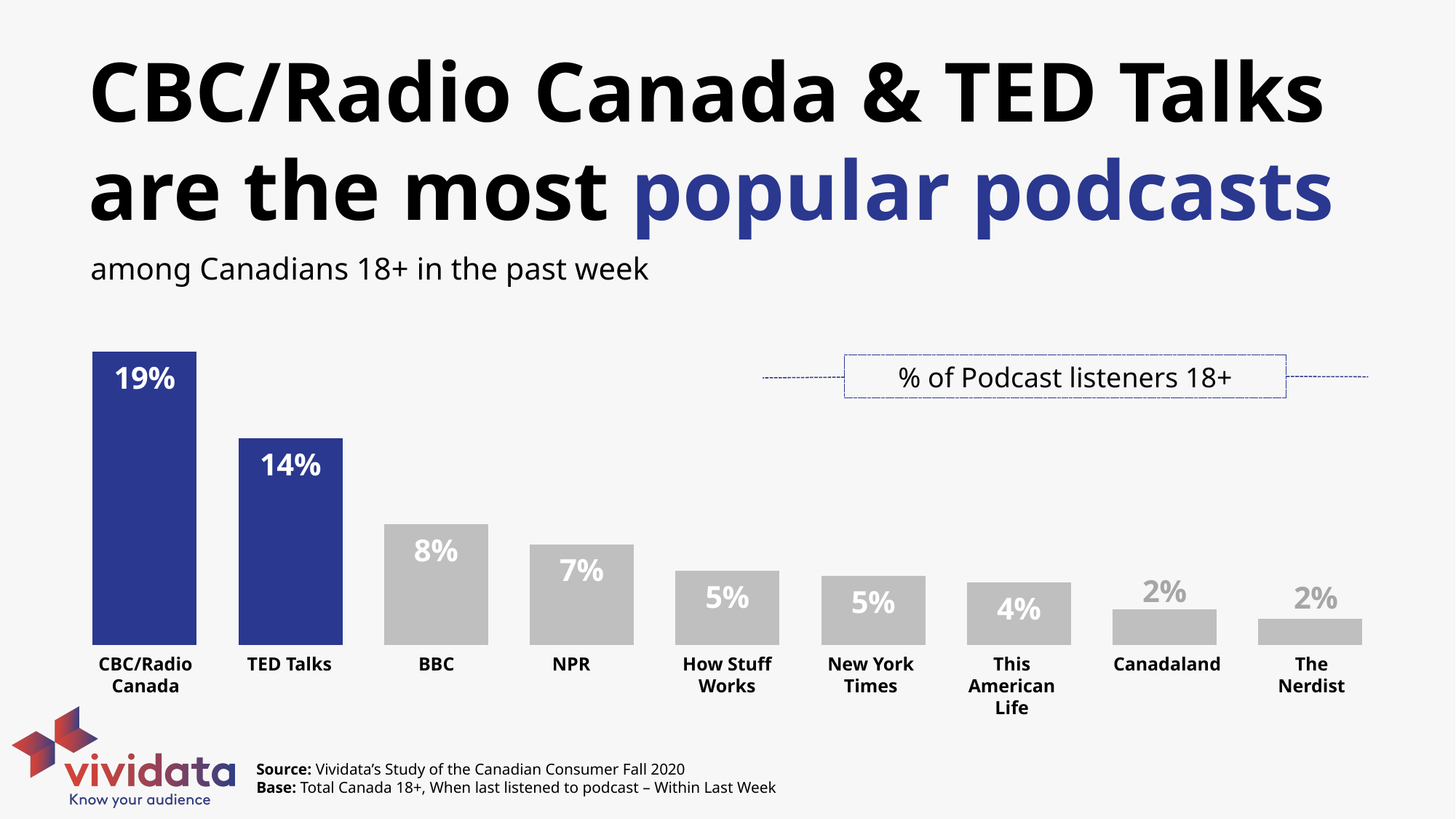
What is the difference between the values for BBC and NPR? 1% What label is shown in the box above the chart describing the measure? % of Podcast listeners 18+ What is the value shown for NPR? 7% Which has a larger value, BBC or How Stuff Works? BBC How many podcasts are shown in the chart? 9 What is the difference between the values for CBC/Radio Canada and TED Talks? 5% Which podcast has the highest percentage of listeners? CBC/Radio Canada What is the value shown for This American Life? 4% Do the values rise or fall from left to right across the chart? Fall What is the value shown for TED Talks? 14% What kind of chart is shown on the slide? Bar chart What percentage of podcast listeners 18+ listened to CBC/Radio Canada? 19%